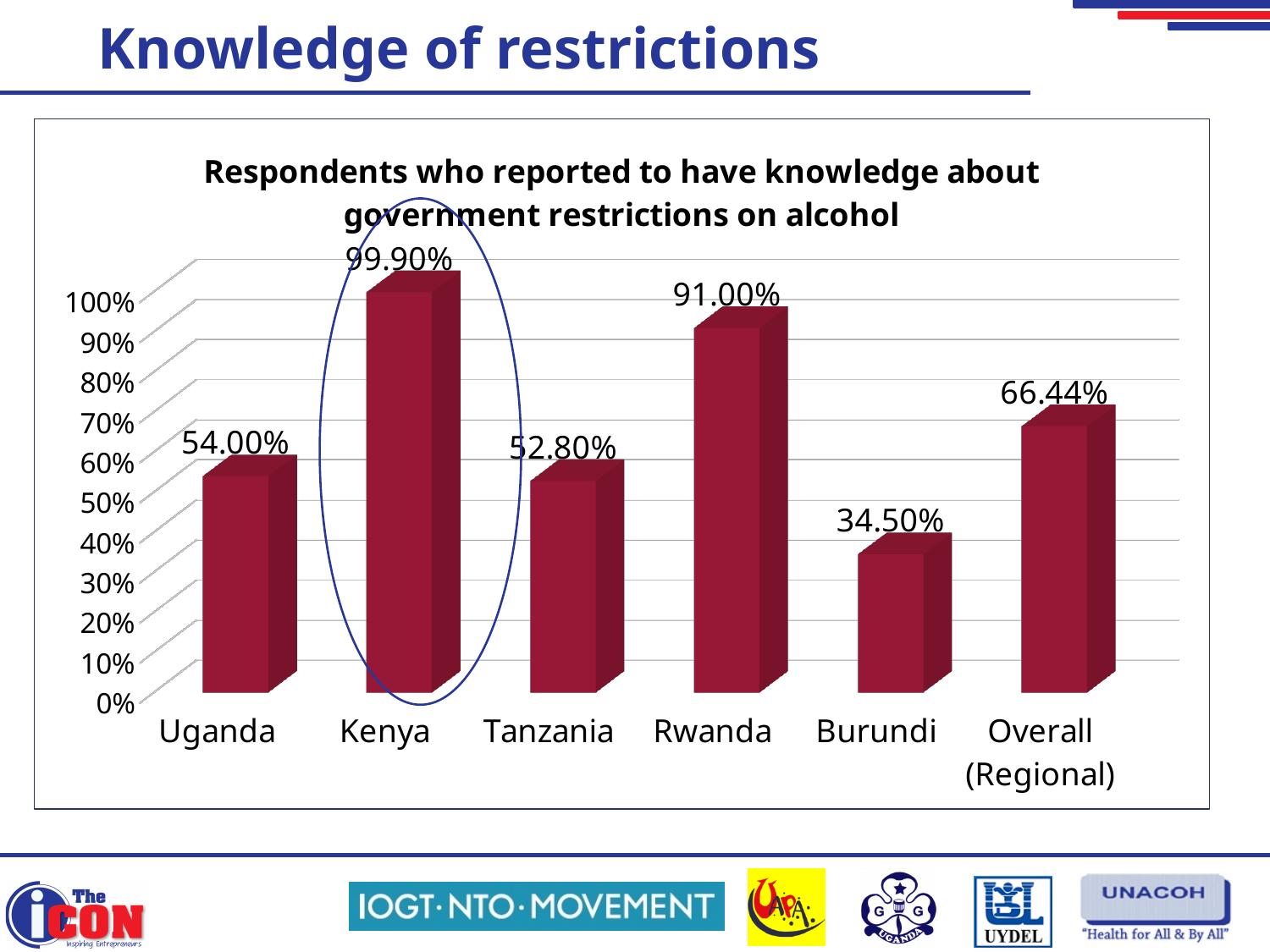
What is the title of the chart? Respondents who reported to have knowledge about government restrictions on alcohol Which bar in the chart is circled? Kenya What is the value shown for Burundi? 34.50% What kind of chart is shown on the slide? Bar chart What is the difference between the values for Rwanda and Tanzania? 38.20% Which category has the lowest value in the chart? Burundi Which country has the highest percentage of respondents with knowledge about government restrictions on alcohol? Kenya Which has a higher value, Uganda or Tanzania? Uganda Is the value for Rwanda greater or less than 80%? greater How many categories are shown on the x axis of the chart? 6 What is the Overall (Regional) value shown in the chart? 66.44% What percentage of respondents in Kenya reported having knowledge about government restrictions on alcohol? 99.90%